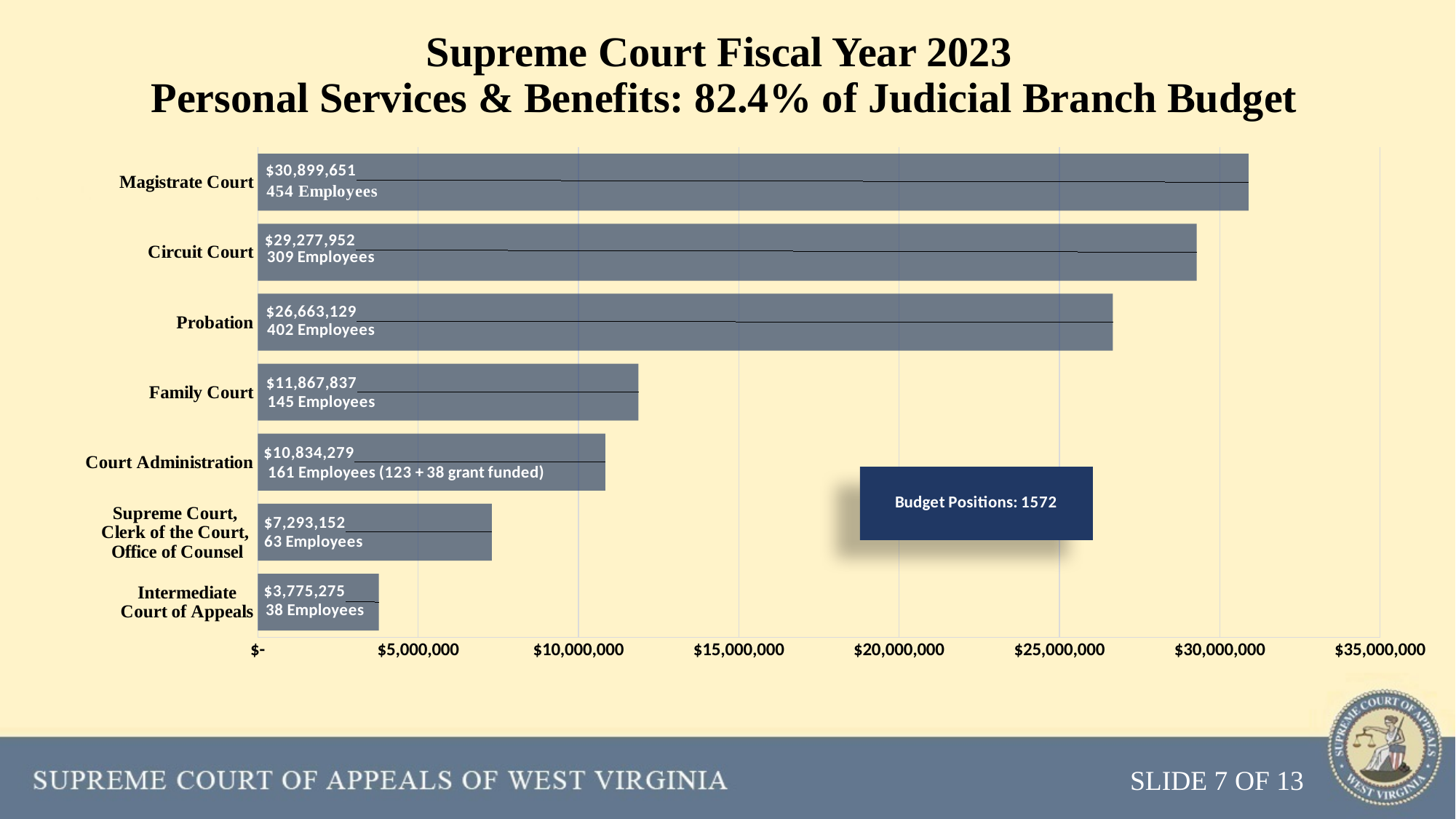
Is the value for Probation greater or less than $25,000,000? greater How many employees does Court Administration have? 161 Employees (123 + 38 grant funded) What is the amount shown for the Intermediate Court of Appeals? $3,775,275 How many employees does Probation have according to the chart? 402 Employees Which category has the lowest Personal Services & Benefits amount? Intermediate Court of Appeals Which category has the highest Personal Services & Benefits amount? Magistrate Court Which has a larger amount, Family Court or Court Administration? Family Court What is the Personal Services & Benefits amount for Magistrate Court? $30,899,651 What number of Budget Positions is shown in the box on the chart? 1572 What kind of chart is shown on the slide? Bar chart How many categories are shown in the chart? 7 What is the difference between the Magistrate Court and Circuit Court amounts? $1,621,699